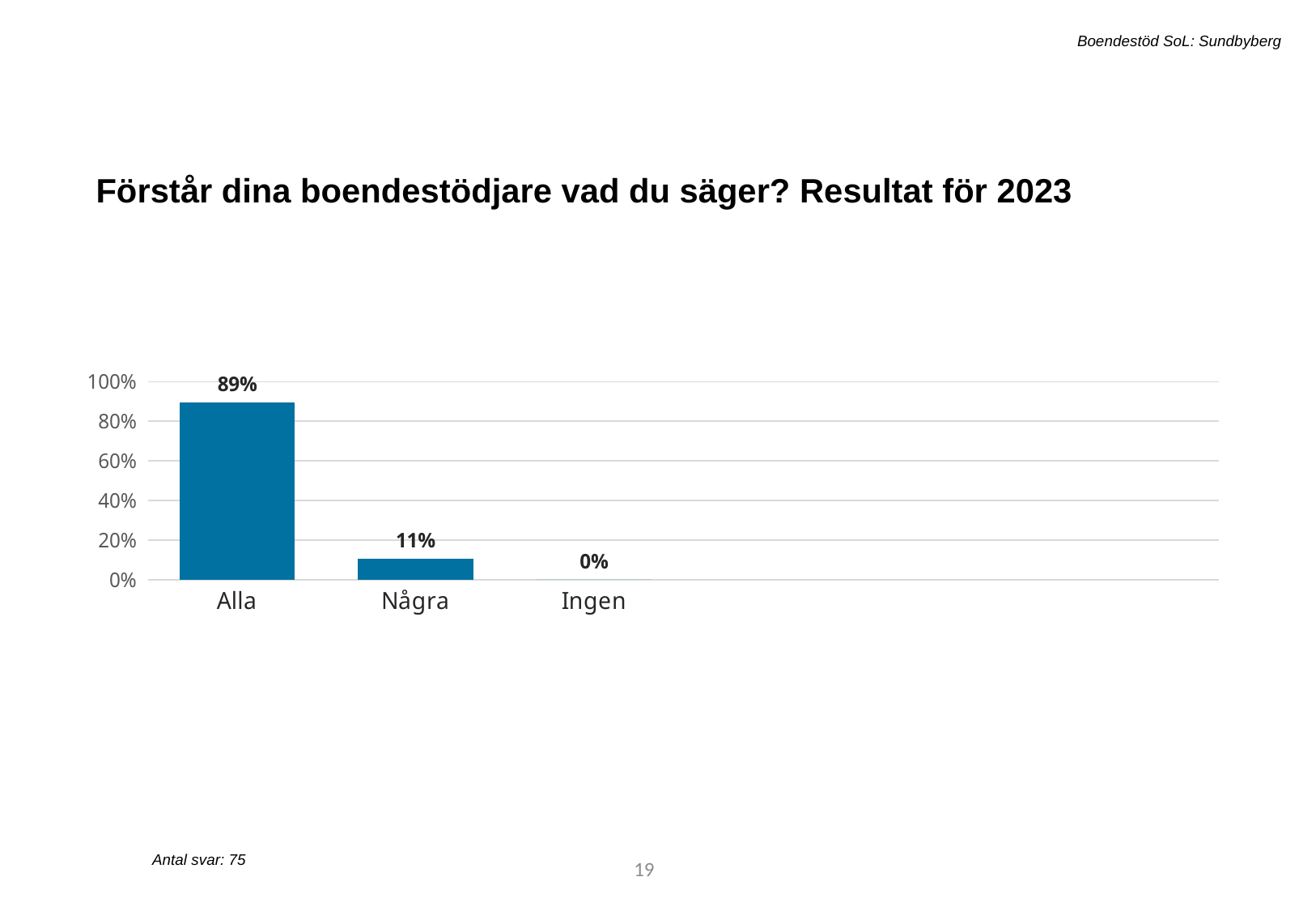
Which category has the highest value? Alla What is the value for Alla? 89% Which is larger, the value for Några or the value for Ingen? Några Is the value for Några greater or less than 20%? less What is the difference between the values for Alla and Några? 78% Is the value for Alla greater or less than 80%? greater Which category has the lowest value? Ingen What kind of chart is shown on the slide? bar chart What is the value for Några? 11% How many categories are shown on the x axis? 3 What is the value for Ingen? 0% Do the values rise or fall from left to right along the x axis? fall